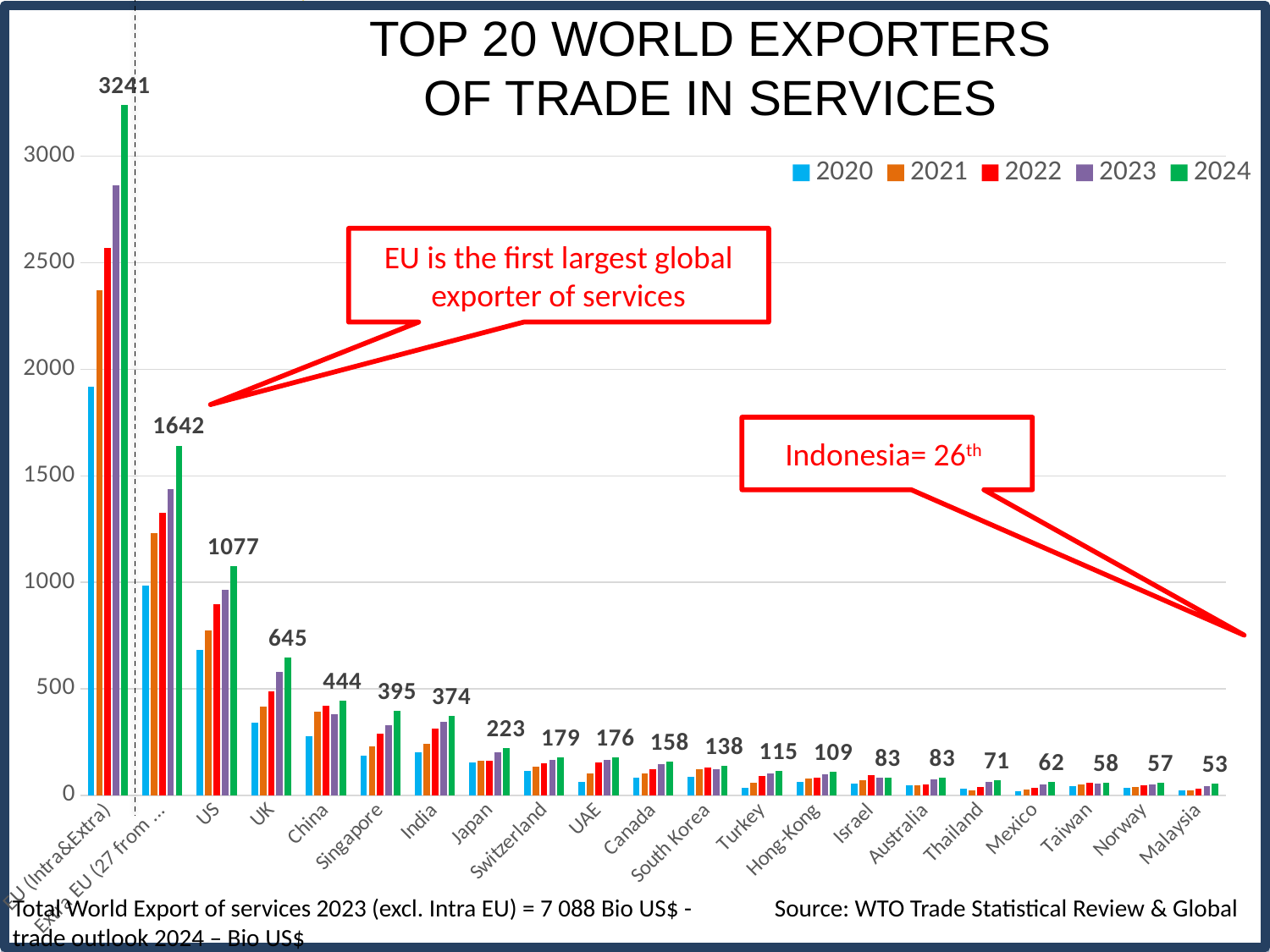
Which has the larger 2024 value, Singapore or India? Singapore Which category has the lowest 2024 value? Malaysia What is the 2024 value for the US? 1077 How many series does the legend list? 5 What is the 2024 value for China? 444 What kind of chart is shown? bar chart Is the 2020 value for the US greater or less than 1000? less Do the values for EU (Intra&Extra) rise or fall from 2020 to 2024? rise Which category has the highest 2024 value? EU (Intra&Extra) What is the 2024 value for Switzerland? 179 What is the difference between the 2024 values for the US and the UK? 432 How many categories are shown on the x axis? 21